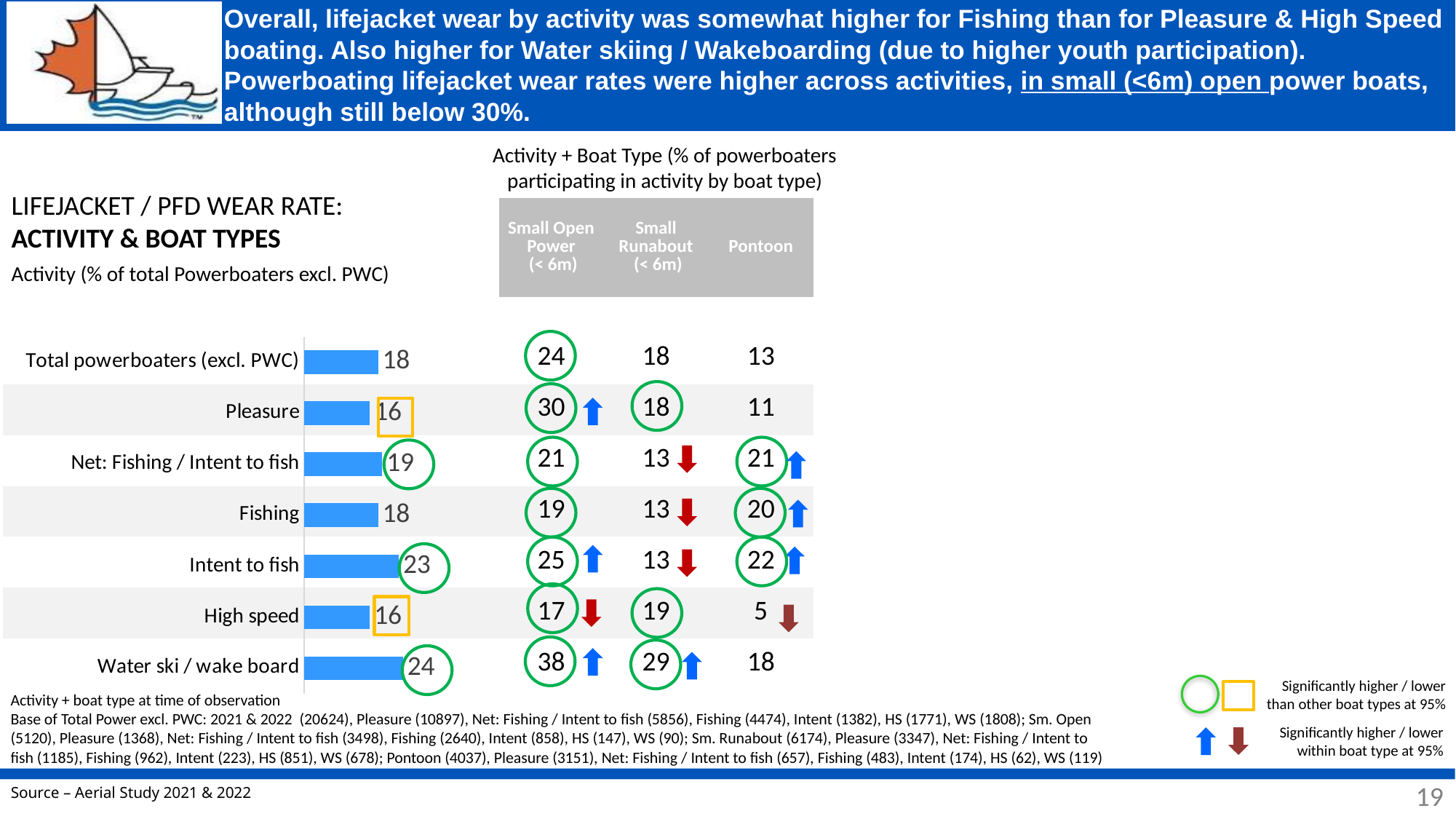
What is the value shown for Intent to fish in the bar chart? 23 Which is larger in the bar chart, the value for Intent to fish or the value for Fishing? Intent to fish In the table to the right of the bar chart, what is the Small Open Power (< 6m) value for Water ski / wake board? 38 What is the difference between the Net: Fishing / Intent to fish value and the High speed value in the bar chart? 3 What type of chart is used to show the activity wear rates? Bar chart What colour are the bars in the bar chart? Blue Which activities share the lowest value in the bar chart? Pleasure and High speed How many activity categories are plotted in the bar chart? 7 What is the lifejacket wear rate shown for Water ski / wake board in the bar chart? 24 What is the value shown for Total powerboaters (excl. PWC) in the bar chart? 18 What is the difference between the Water ski / wake board value and the Pleasure value in the bar chart? 8 Which activity has the highest wear rate in the bar chart? Water ski / wake board